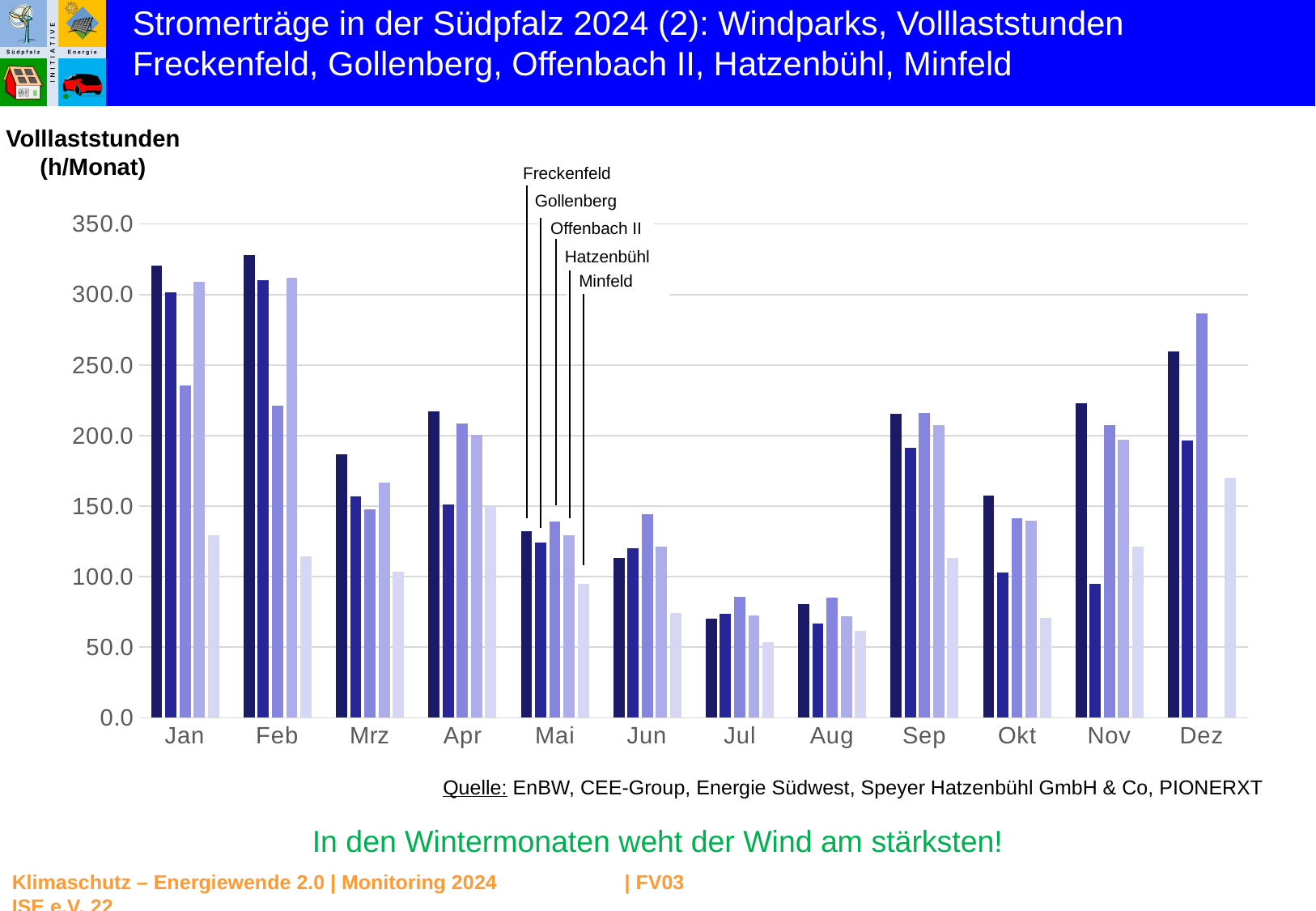
What unit is given for the y axis of the chart? h/Monat In Nov, which is larger: the value for Freckenfeld or the value for Gollenberg? Freckenfeld Is the value for Minfeld in Jul greater or less than 100? less Which wind park has the lowest value in Jan? Minfeld Do the values for Freckenfeld rise or fall from Feb to Jul? fall How many months are shown along the x axis of the chart? 12 Is the value for Freckenfeld in Jan greater or less than 300? greater What conclusion is written in green below the chart? In den Wintermonaten weht der Wind am stärksten! How many wind parks (series) does the chart legend list? 5 What kind of chart is shown on the slide? bar chart Which wind park has the highest value in Dez? Offenbach II Is the value for Offenbach II in Sep greater or less than 200? greater